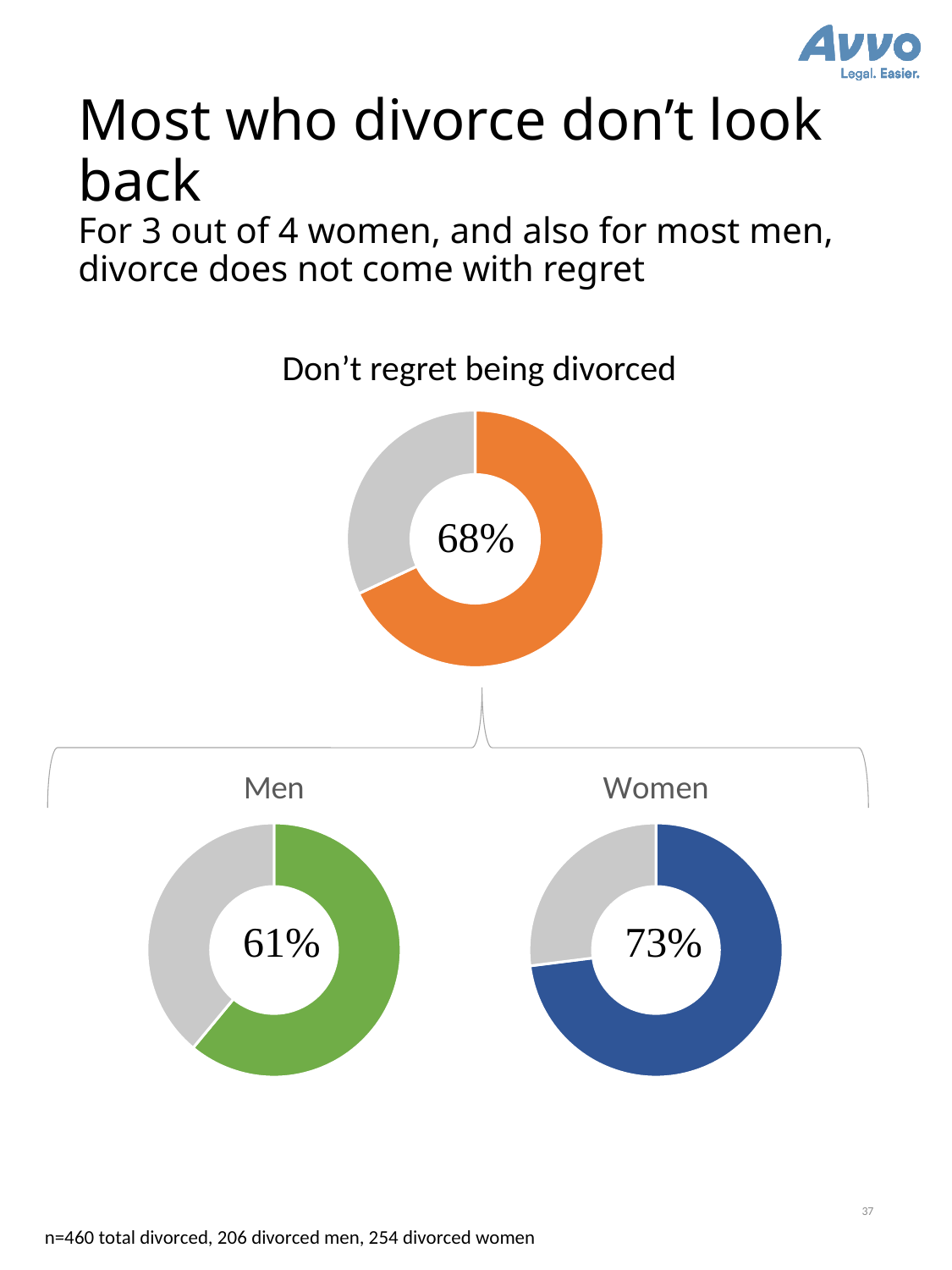
How many percentage points higher is the Women chart value than the overall top chart value? 5 percentage points Comparing the Men and Women doughnut charts, which group has the higher share who don't regret being divorced? Women How many doughnut charts are shown on the slide? 3 In the Men doughnut chart, what percentage of men don't regret being divorced? 61% In the Men doughnut chart, what share of the ring is the grey (remaining) portion? 39% What colour is the highlighted segment in the Women doughnut chart? Blue In the Women doughnut chart, what percentage of women don't regret being divorced? 73% In the Men doughnut chart, is the value greater or less than 50%? greater What is the difference in percentage points between the Women chart value and the Men chart value? 12 percentage points In the top doughnut chart titled "Don't regret being divorced", what percentage is shown in the centre? 68% What kind of chart is used to show the percentages on this slide? Doughnut chart How many percentage points lower is the Men chart value than the overall top chart value? 7 percentage points